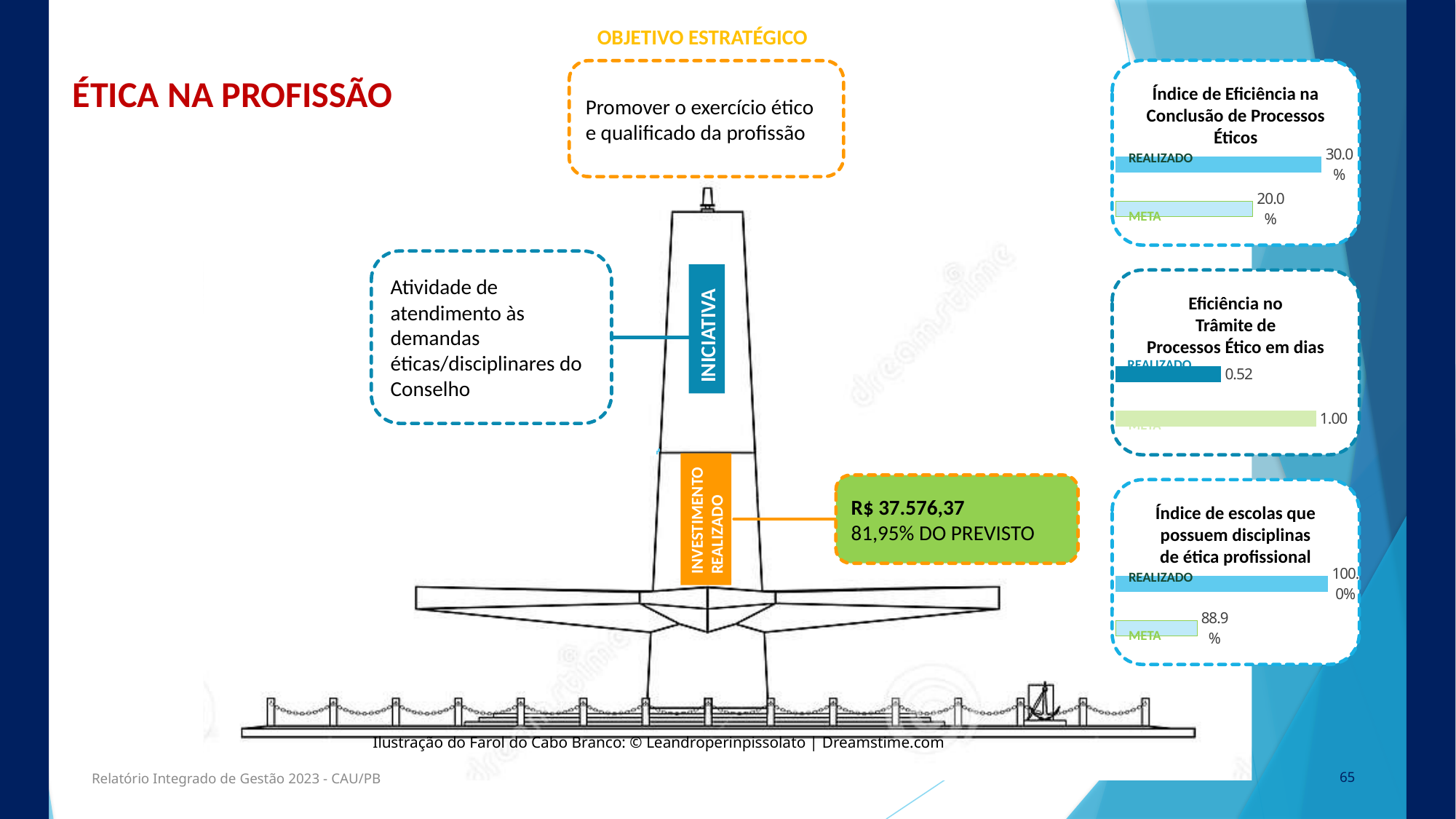
In the chart titled 'Índice de Eficiência na Conclusão de Processos Éticos', which bar is larger, REALIZADO or META? REALIZADO What kind of chart is the one titled 'Eficiência no Trâmite de Processos Ético em dias'? Bar chart In the chart titled 'Índice de escolas que possuem disciplinas de ética profissional', which bar is the highest? REALIZADO In the chart titled 'Eficiência no Trâmite de Processos Ético em dias', what is the value for META? 1.00 In the chart titled 'Índice de Eficiência na Conclusão de Processos Éticos', what is the value for META? 20.0% In the chart titled 'Eficiência no Trâmite de Processos Ético em dias', which bar is larger, REALIZADO or META? META In the chart titled 'Eficiência no Trâmite de Processos Ético em dias', what is the value for REALIZADO? 0.52 In the chart titled 'Índice de escolas que possuem disciplinas de ética profissional', what is the value for META? 88.9% How many bars does the chart titled 'Índice de escolas que possuem disciplinas de ética profissional' show? 2 In the chart titled 'Índice de Eficiência na Conclusão de Processos Éticos', what is the difference between REALIZADO and META? 10.0% In the chart titled 'Índice de escolas que possuem disciplinas de ética profissional', what is the value for REALIZADO? 100.0% In the chart titled 'Índice de Eficiência na Conclusão de Processos Éticos', what is the value for REALIZADO? 30.0%